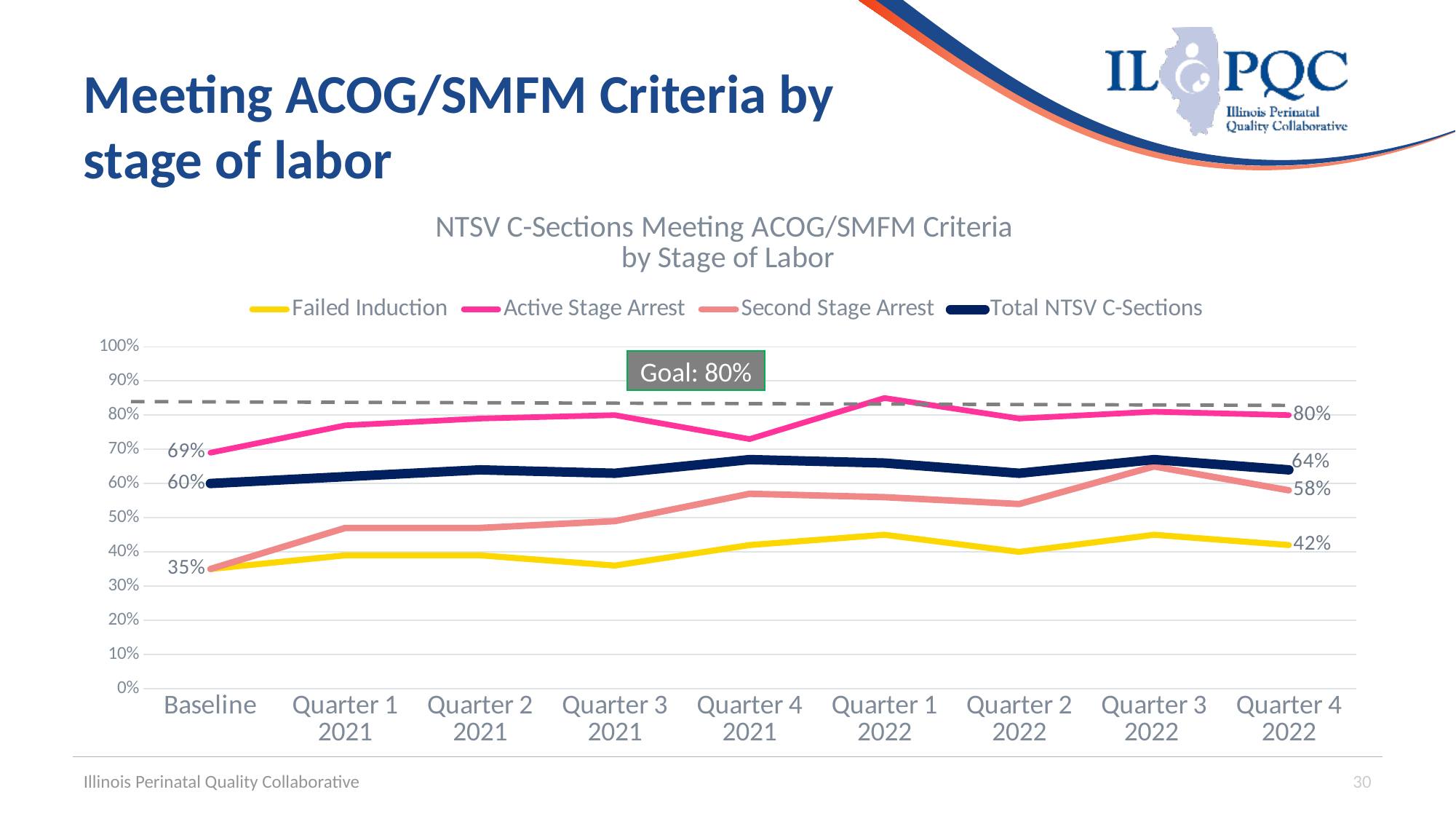
What is the Active Stage Arrest value at Baseline? 69% Is the Second Stage Arrest value in Quarter 3 2022 greater or less than 60%? greater What is the Second Stage Arrest value in Quarter 4 2022? 58% How many series does the legend list? 4 What is the Active Stage Arrest value in Quarter 4 2022? 80% By how many percentage points did Active Stage Arrest change from Baseline to Quarter 4 2022? 11 percentage points What is the Total NTSV C-Sections value in Quarter 4 2022? 64% How many time points are shown on the x axis? 9 What goal value is marked by the dashed line on the chart? 80% What kind of chart is shown on the slide? Line chart What is the Failed Induction value in Quarter 4 2022? 42% What is the Total NTSV C-Sections value at Baseline? 60%